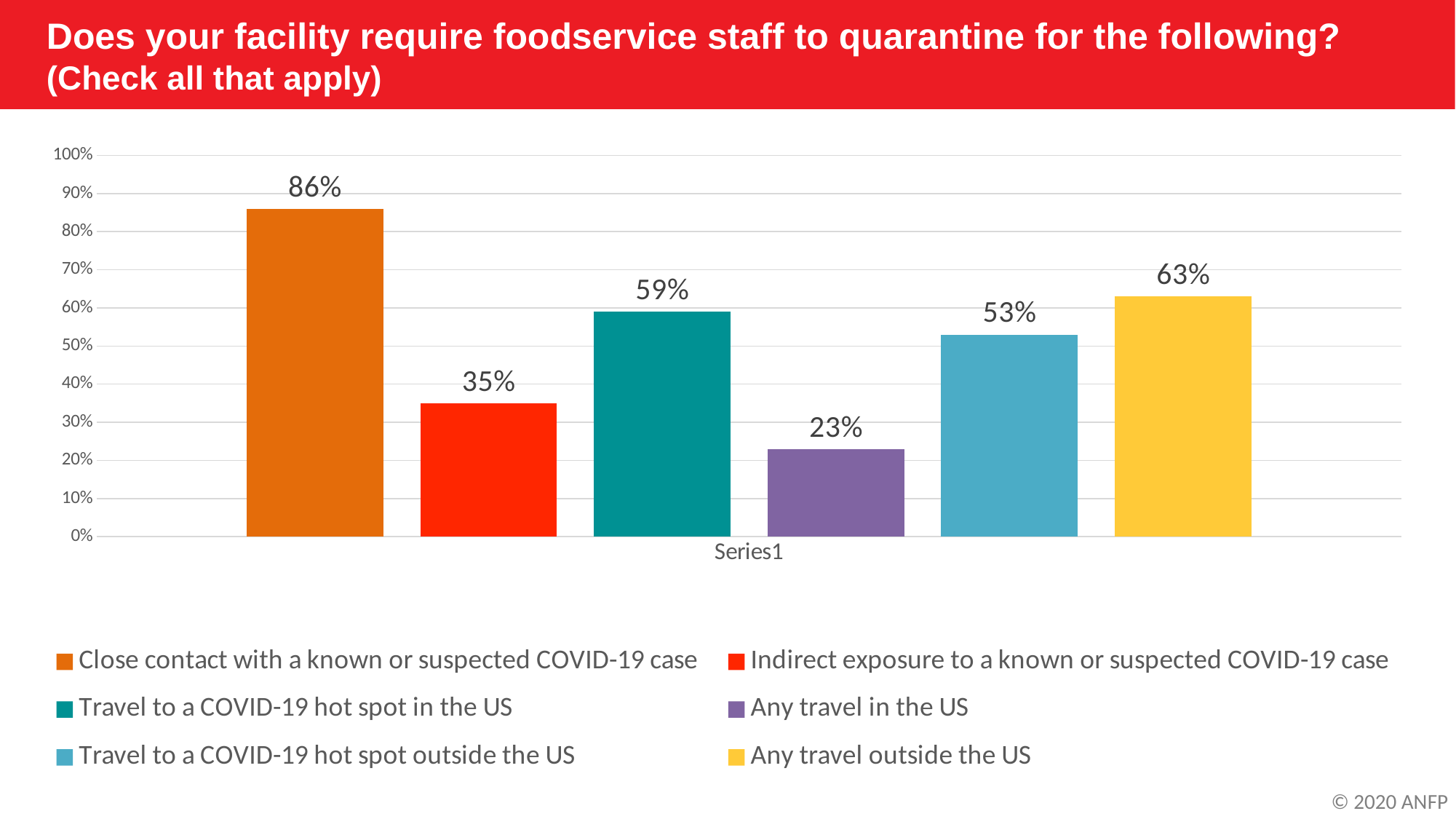
Which quarantine reason has the highest percentage? Close contact with a known or suspected COVID-19 case What percentage of facilities require quarantine for any travel in the US? 23% What is the difference between the percentage for close contact with a known or suspected COVID-19 case and the percentage for indirect exposure to a known or suspected COVID-19 case? 51% What kind of chart is shown on the slide? Bar chart Is the value for indirect exposure to a known or suspected COVID-19 case greater or less than 40%? less What is the difference between the percentage for any travel outside the US and the percentage for any travel in the US? 40% What percentage of facilities require foodservice staff to quarantine for close contact with a known or suspected COVID-19 case? 86% What percentage of facilities require quarantine for travel to a COVID-19 hot spot outside the US? 53% Which quarantine reason has the lowest percentage? Any travel in the US What colour is the bar for any travel outside the US? Yellow Which is larger: the percentage for travel to a COVID-19 hot spot in the US or the percentage for travel to a COVID-19 hot spot outside the US? Travel to a COVID-19 hot spot in the US How many quarantine reasons are plotted in the chart? 6